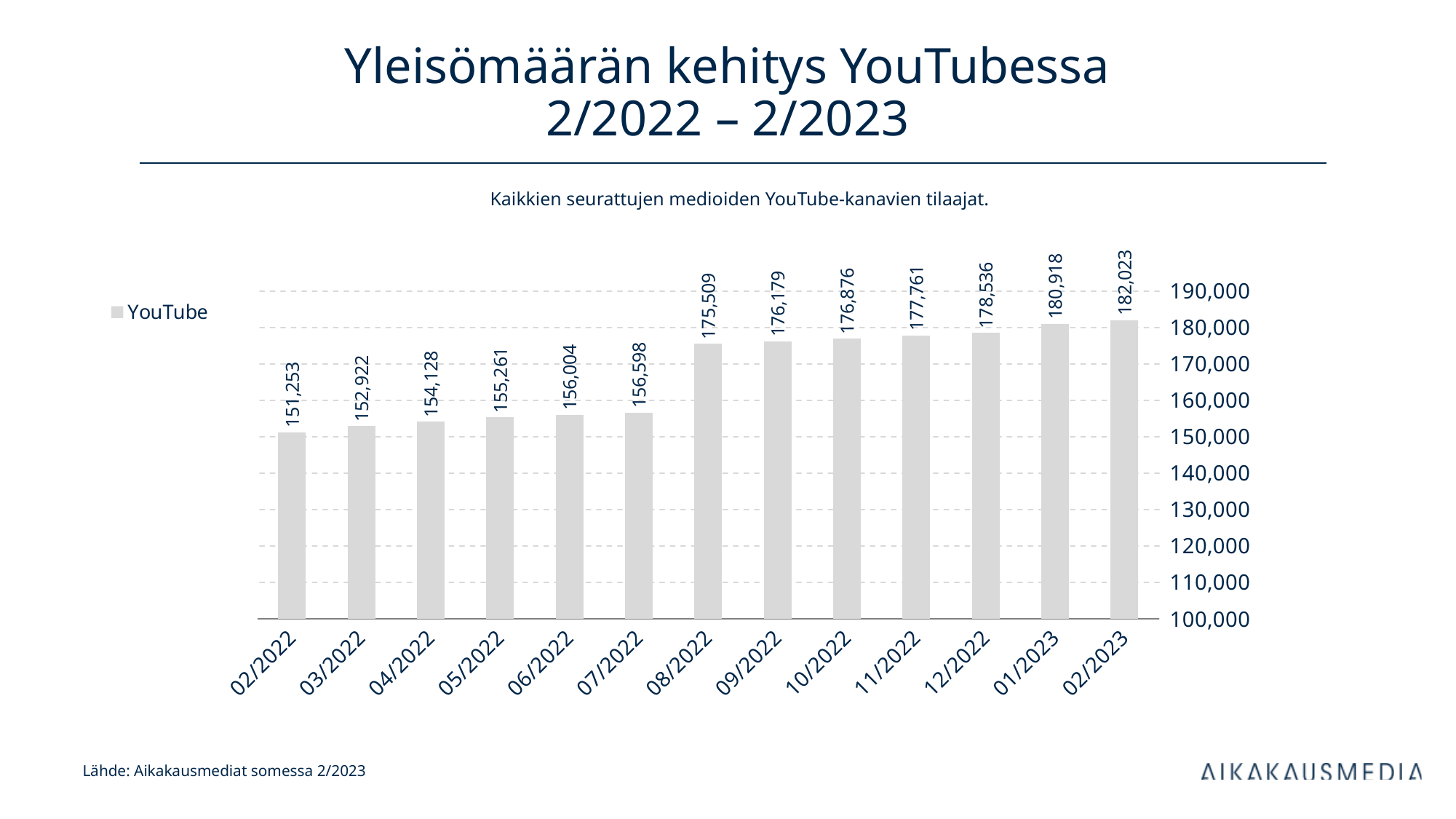
What kind of chart is shown on the slide? bar chart What is the value for 02/2023? 182,023 Which month has the lowest value? 02/2022 Which is larger, the value for 06/2022 or the value for 09/2022? 09/2022 Is the value for 05/2022 greater or less than 160,000? less How many months are shown on the x axis? 13 Do the values rise or fall from 02/2022 to 02/2023? rise What is the value for 08/2022? 175,509 What is the difference between the values for 08/2022 and 07/2022? 18,911 Which month has the highest value? 02/2023 What is the value for 02/2022? 151,253 What is the difference between the values for 02/2023 and 02/2022? 30,770